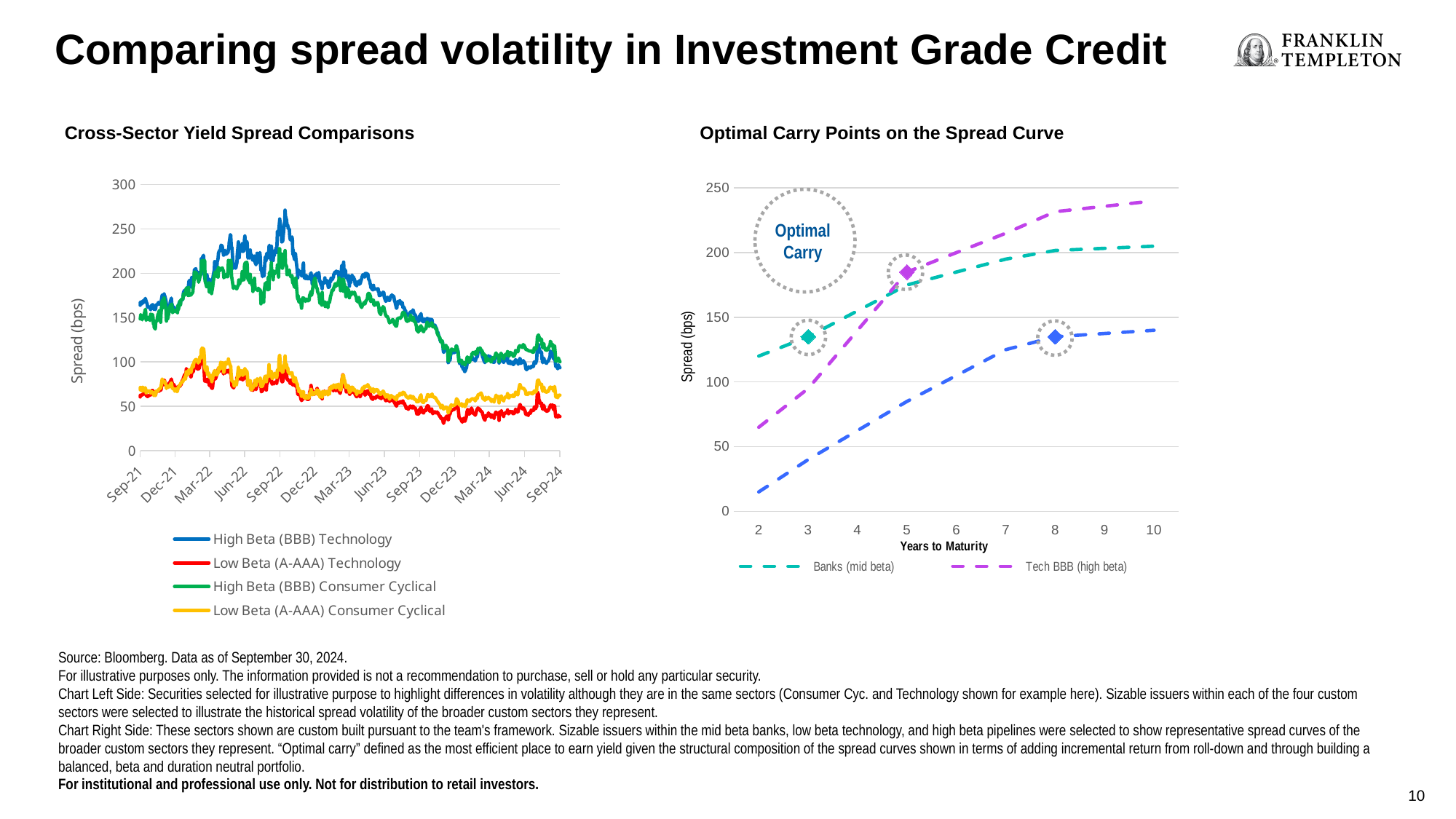
How many series does the legend of the 'Cross-Sector Yield Spread Comparisons' chart list? 4 In the 'Cross-Sector Yield Spread Comparisons' chart, is the value for Low Beta (A-AAA) Technology at Sep-24 greater or less than 50? less In the 'Cross-Sector Yield Spread Comparisons' chart, does the High Beta (BBB) Technology spread rise or fall from Sep-22 to Sep-24? fall In the 'Cross-Sector Yield Spread Comparisons' chart, is the peak value of High Beta (BBB) Technology around Sep-22 greater or less than 250? greater How many series does the legend of the 'Optimal Carry Points on the Spread Curve' chart list? 2 What is the y-axis label of the 'Cross-Sector Yield Spread Comparisons' chart? Spread (bps) In the 'Cross-Sector Yield Spread Comparisons' chart, which is larger at Sep-24: High Beta (BBB) Consumer Cyclical or Low Beta (A-AAA) Consumer Cyclical? High Beta (BBB) Consumer Cyclical What kind of chart is the 'Cross-Sector Yield Spread Comparisons' chart on the left? line chart In the 'Optimal Carry Points on the Spread Curve' chart, does the Banks (mid beta) spread rise or fall as years to maturity increase? rise How many date labels are shown on the x axis of the 'Cross-Sector Yield Spread Comparisons' chart? 13 In the 'Optimal Carry Points on the Spread Curve' chart, which is larger at 10 years to maturity: Banks (mid beta) or Tech BBB (high beta)? Tech BBB (high beta) In the 'Optimal Carry Points on the Spread Curve' chart, is the value for Tech BBB (high beta) at 10 years to maturity greater or less than 200? greater